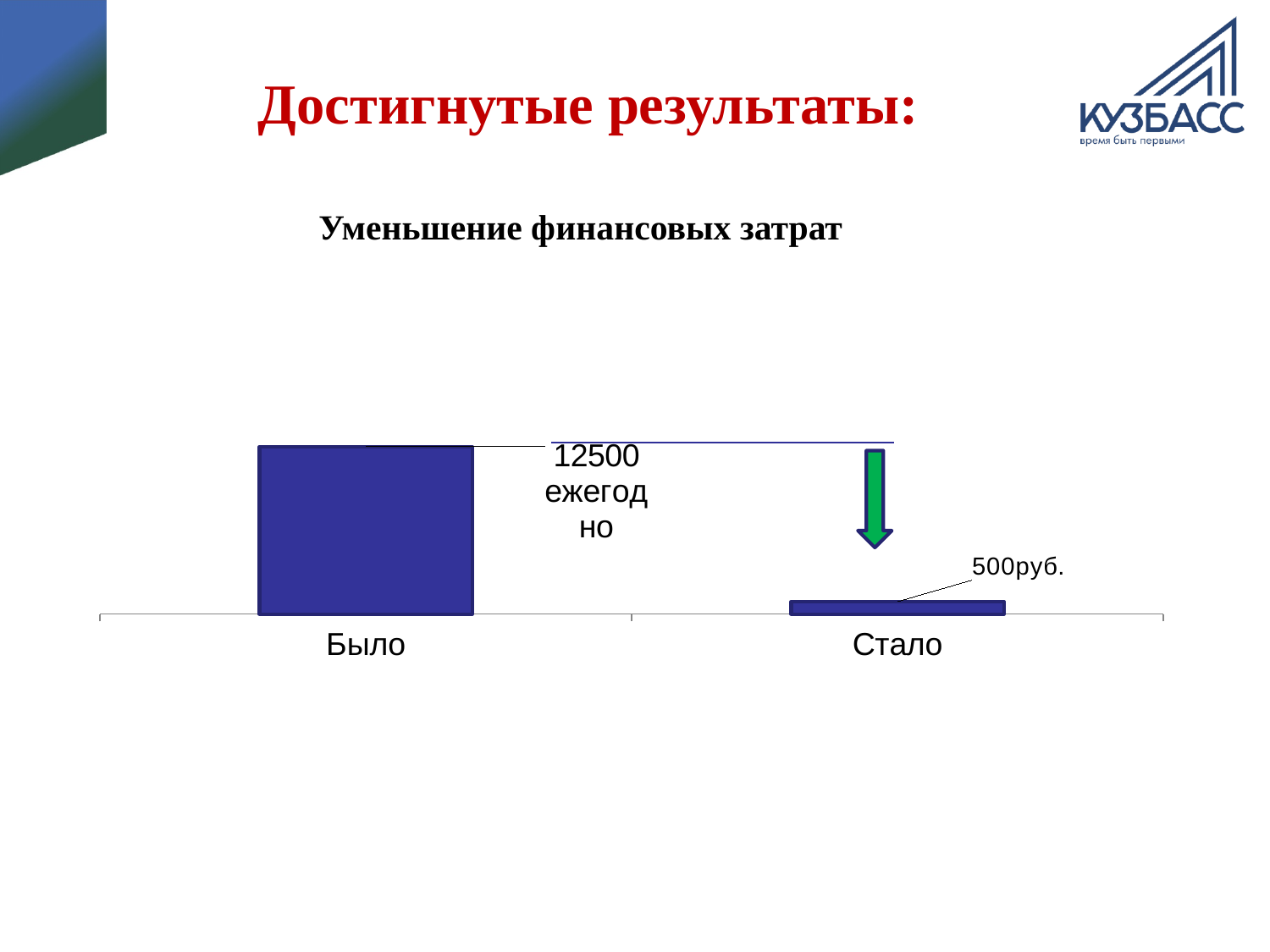
What value is shown for the "Было" bar? 12500 ежегодно Which category has the lowest value? Стало How many categories are shown on the x axis of the chart? 2 Do the values rise or fall from "Было" to "Стало"? Fall What value is shown for the "Стало" bar? 500руб. Which is larger, the value for "Было" or the value for "Стало"? Было Which category has the highest value? Было What kind of chart is shown on the slide? Bar chart What is the heading written above the chart? Уменьшение финансовых затрат What colour are the bars in the chart? Blue By how much does the value for "Было" exceed the value for "Стало"? 12000